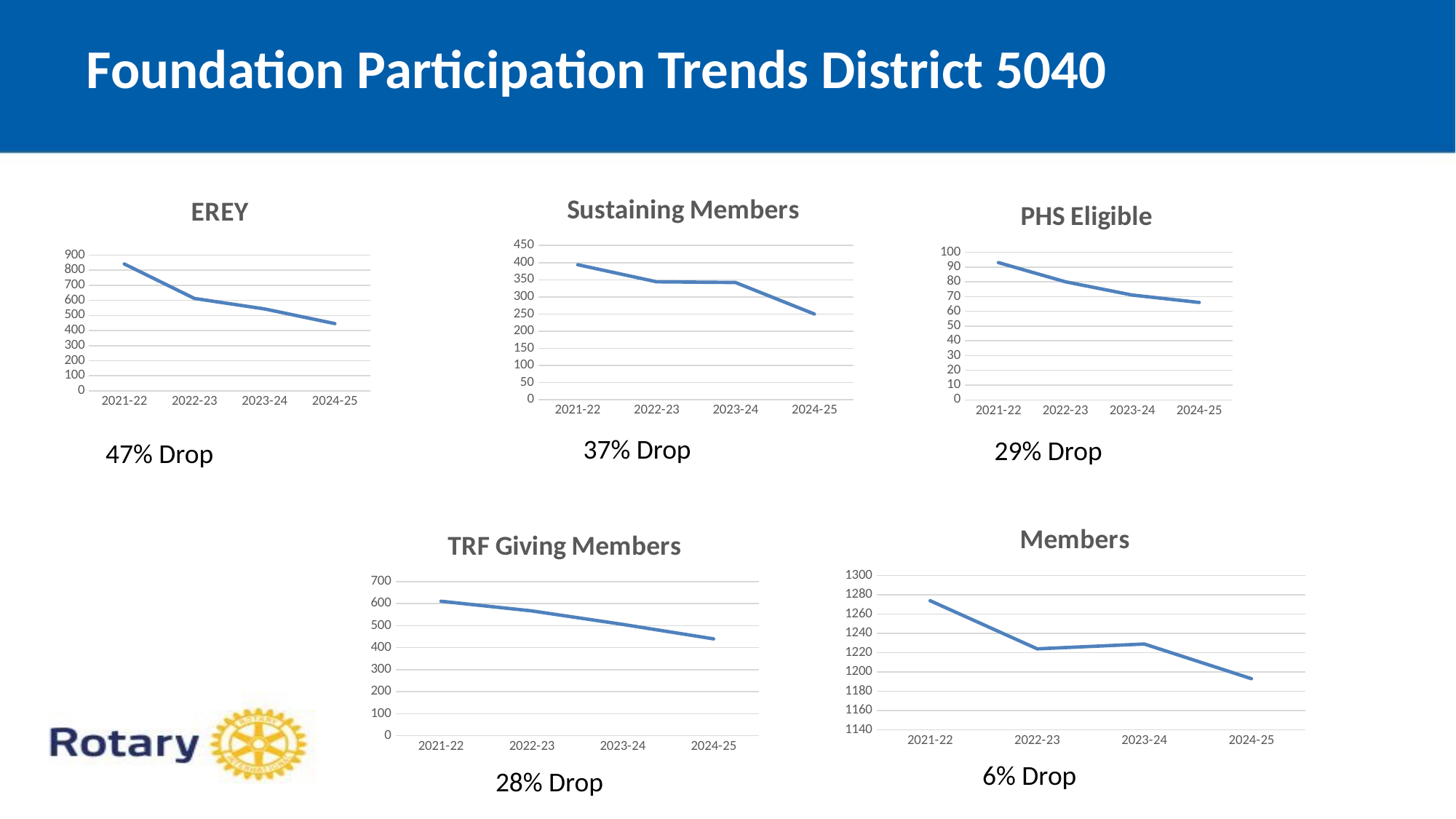
In the EREY chart, is the value for 2021-22 greater or less than 800? greater In the Members chart, which year has the lowest value? 2024-25 How many charts are shown on the slide? 5 In the PHS Eligible chart, is the value for 2021-22 greater or less than 80? greater In the Sustaining Members chart, which year has the highest value? 2021-22 In the EREY chart, how many data points are plotted along the x axis? 4 In the Sustaining Members chart, is the value for 2024-25 greater or less than 300? less In the Members chart, is the value for 2021-22 larger or smaller than the value for 2022-23? larger What kind of chart is the EREY chart? line chart In the PHS Eligible chart, do the values rise or fall from 2021-22 to 2024-25? fall